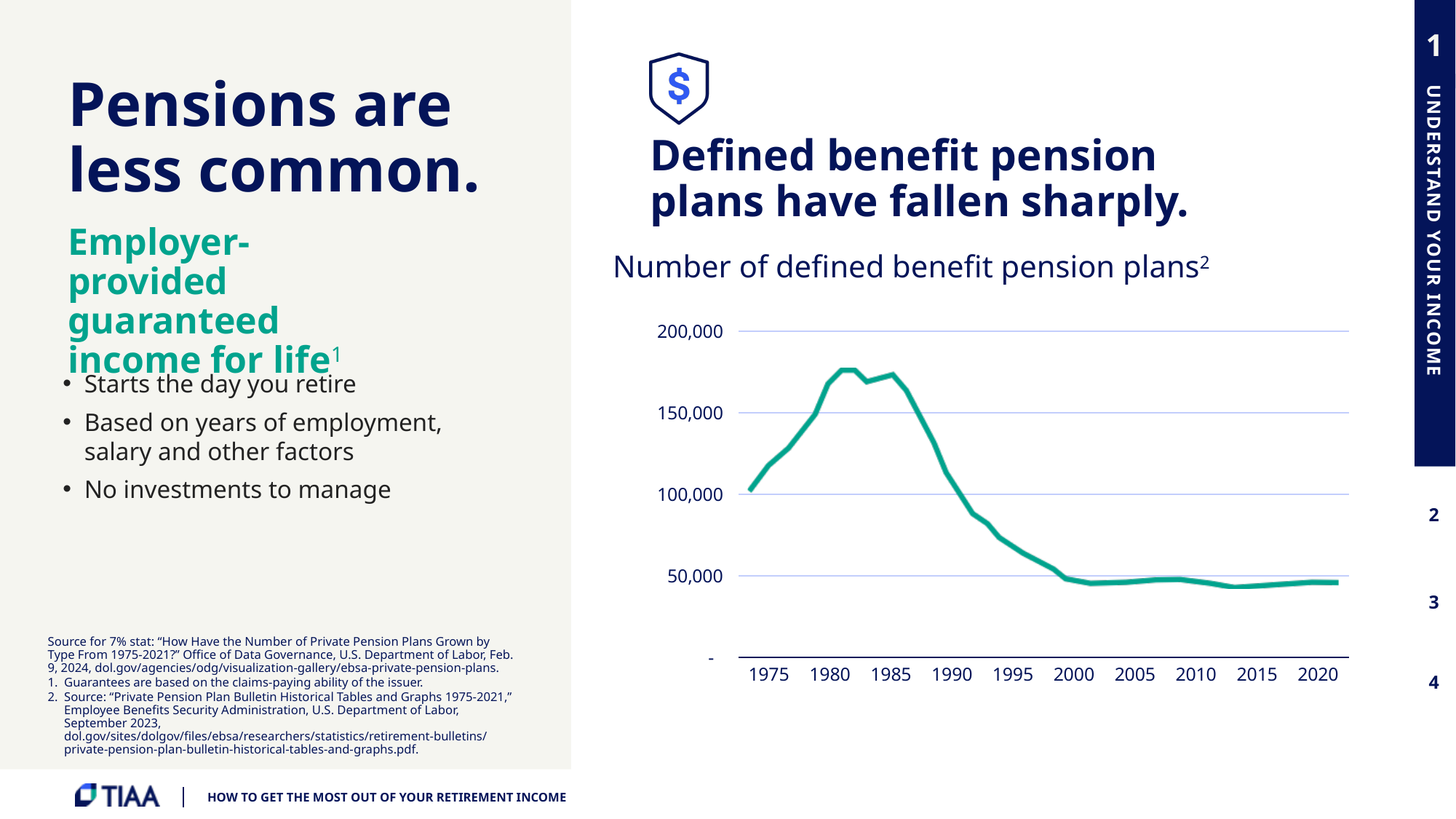
Is the value for 1985 greater or less than 150,000? greater Is the value for 1990 greater or less than 150,000? less How many year labels are shown on the x axis? 10 Between 1985 and 2000, does the line rise or fall? fall Is the value for 2000 greater or less than 100,000? less In which decade does the line reach its highest point? 1980s Between 1975 and 1980, does the line rise or fall? rise What is the title of the chart? Number of defined benefit pension plans What kind of chart is shown on the slide? Line chart Which year has the larger value, 1985 or 2005? 1985